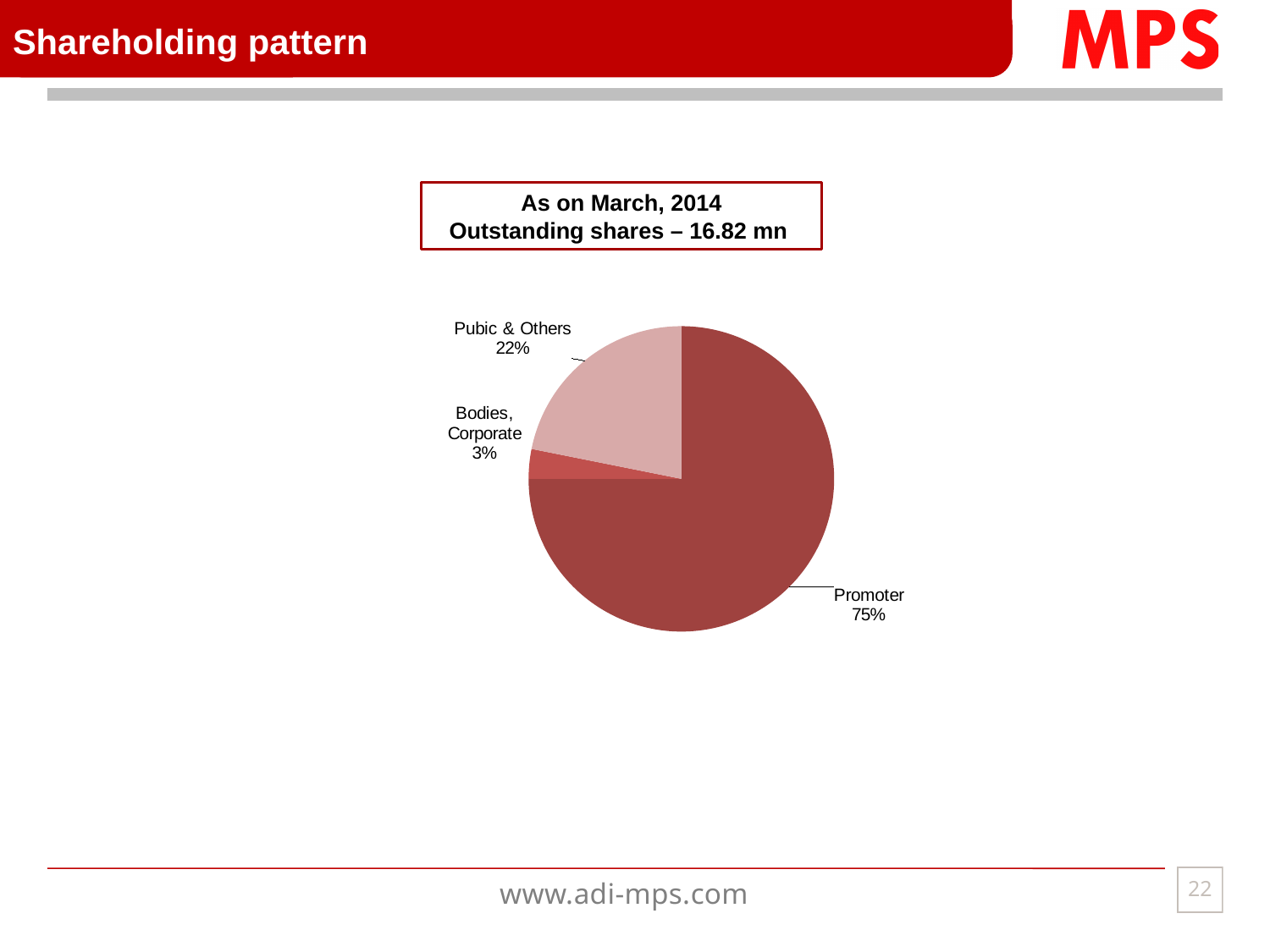
Which is larger, the Pubic & Others slice or the Bodies, Corporate slice? Pubic & Others What share of the pie does Bodies, Corporate hold? 3% What is the difference in percentage points between the Pubic & Others slice and the Bodies, Corporate slice? 19 Which category has the smallest slice of the pie? Bodies, Corporate What kind of chart is shown on the slide? Pie chart According to the box above the chart, how many outstanding shares are there as on March, 2014? 16.82 mn What is the difference in percentage points between the Promoter slice and the Pubic & Others slice? 53 What is the combined share of Pubic & Others and Bodies, Corporate? 25% What share of the pie does Promoter hold? 75% Which category has the largest slice of the pie? Promoter How many slices does the pie chart have? 3 What share of the pie does Pubic & Others hold? 22%